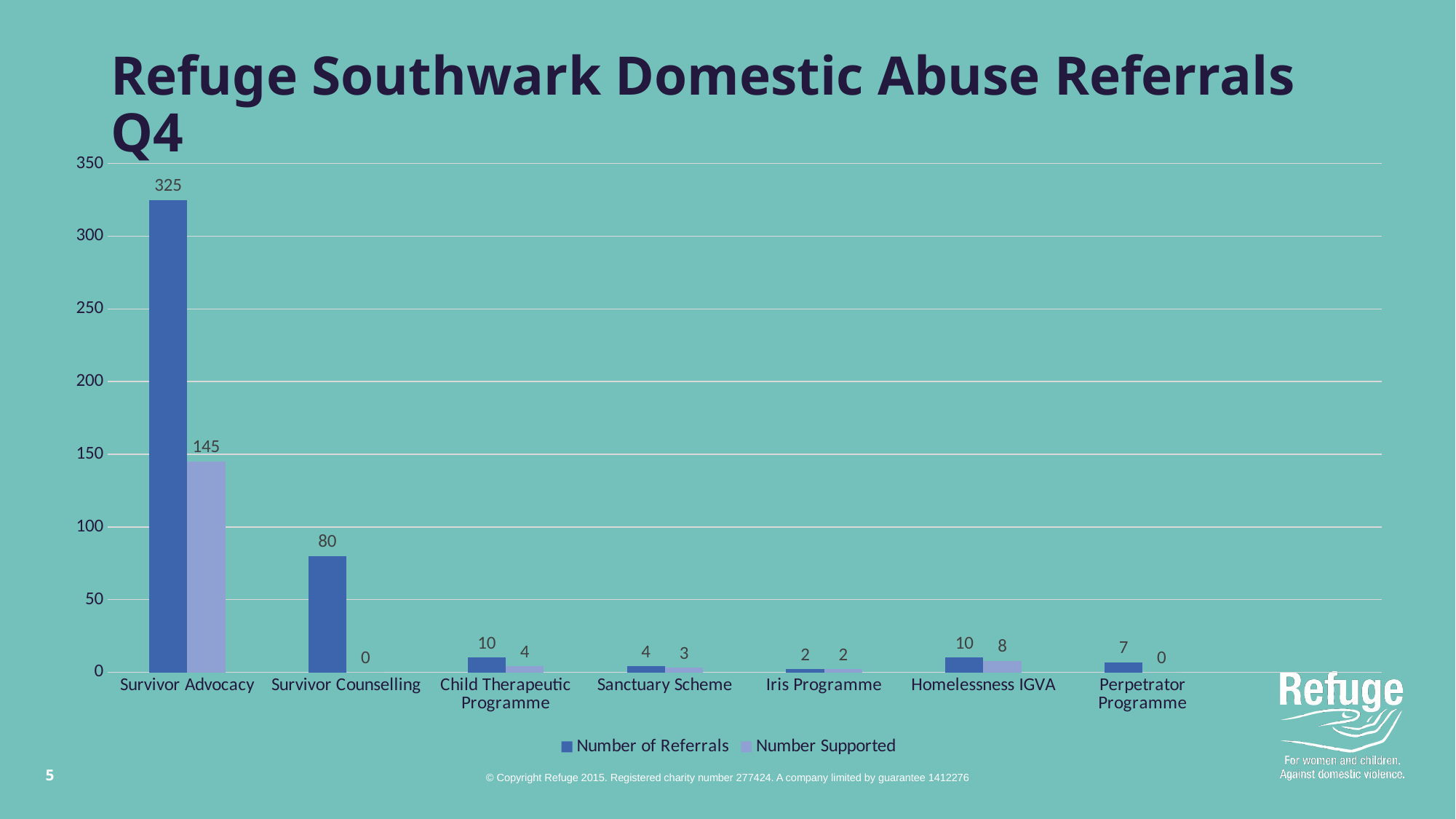
What kind of chart is shown on the slide? Bar chart How many categories are shown on the x axis? 7 What is the Number Supported for Survivor Counselling? 0 Which category has the lowest Number of Referrals? Iris Programme Is the Number of Referrals for Survivor Counselling greater or less than 100? less What is the difference between the Number of Referrals and the Number Supported for Survivor Advocacy? 180 What is the Number Supported for Homelessness IGVA? 8 What is the Number of Referrals for Survivor Advocacy? 325 Which is larger: the Number of Referrals for Child Therapeutic Programme or for Perpetrator Programme? Child Therapeutic Programme What is the title of the chart? Refuge Southwark Domestic Abuse Referrals Q4 Which category has the highest Number of Referrals? Survivor Advocacy How many series does the legend list? 2